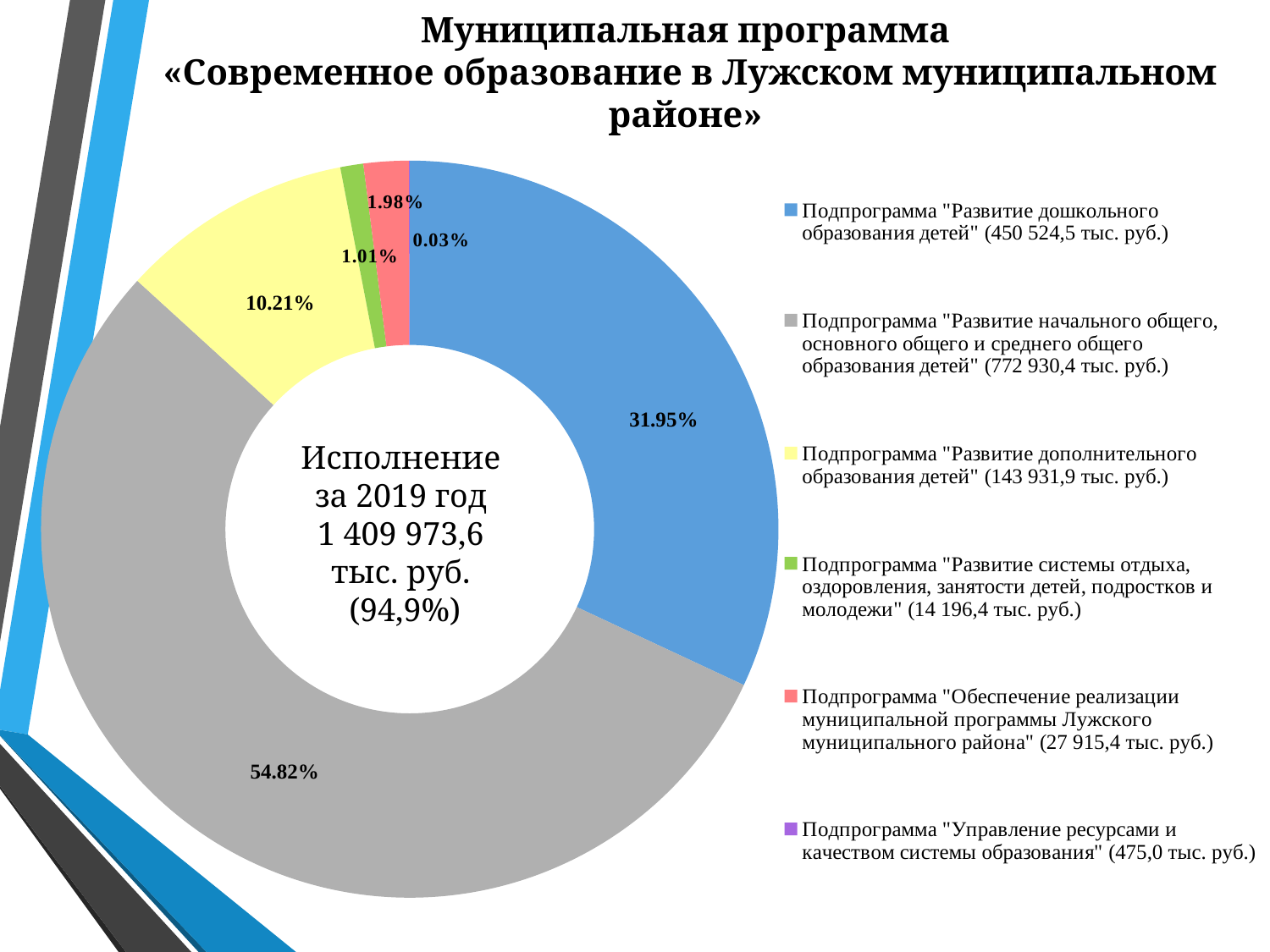
How many subprograms (categories) does the legend list? 6 Which subprogram has the smallest share of the chart? Подпрограмма "Управление ресурсами и качеством системы образования" What colour represents the subprogram "Обеспечение реализации муниципальной программы Лужского муниципального района" in the chart? Red (pink) Which subprogram has the largest share of the chart? Подпрограмма "Развитие начального общего, основного общего и среднего общего образования детей" What is the difference in percentage points between the largest slice (54.82%) and the slice for "Развитие дошкольного образования детей" (31.95%)? 22.87 What total execution amount for 2019 is shown in the centre of the chart? 1 409 973,6 тыс. руб. (94,9%) What share of the chart does the subprogram "Развитие дополнительного образования детей" take? 10.21% What share of the chart does the subprogram "Развитие дошкольного образования детей" take? 31.95% Which slice is larger: "Развитие дополнительного образования детей" or "Обеспечение реализации муниципальной программы Лужского муниципального района"? Развитие дополнительного образования детей According to the legend, what amount corresponds to the subprogram "Развитие начального общего, основного общего и среднего общего образования детей"? 772 930,4 тыс. руб. What kind of chart is shown on the slide? Doughnut (pie) chart According to the legend, what amount corresponds to the subprogram "Развитие системы отдыха, оздоровления, занятости детей, подростков и молодежи"? 14 196,4 тыс. руб.